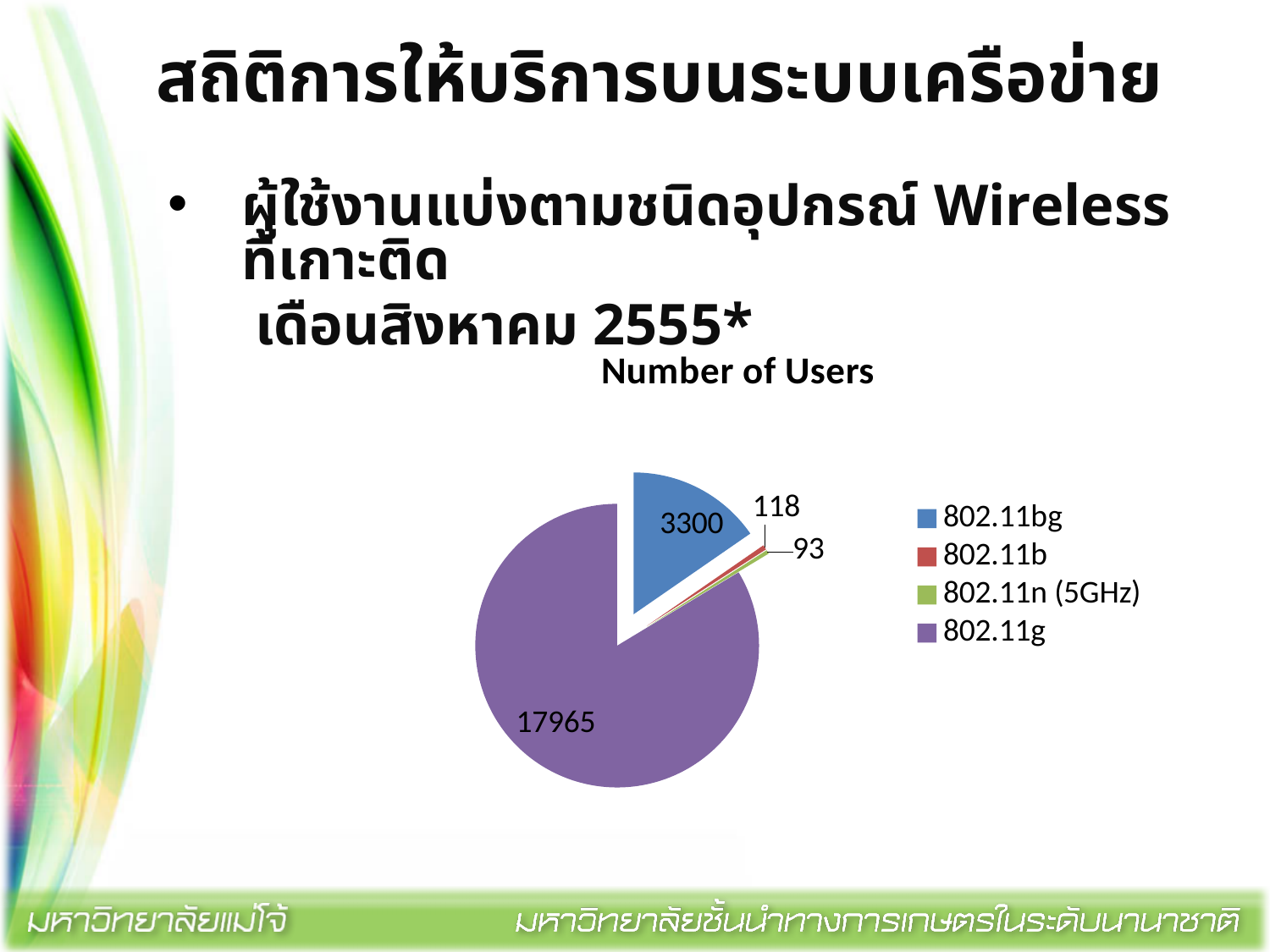
What is the number of users for 802.11bg? 3300 What type of chart is shown on the slide? pie chart How many entries does the legend list? 4 Which wireless type has the largest number of users? 802.11g What is the number of users for 802.11b? 118 Which wireless type has the smallest number of users? 802.11n (5GHz) How many slices does the pie chart have? 4 What is the title of the chart? Number of Users What is the number of users for 802.11n (5GHz)? 93 What is the number of users for 802.11g? 17965 Which has more users, 802.11b or 802.11n (5GHz)? 802.11b What is the difference in users between 802.11g and 802.11bg? 14665